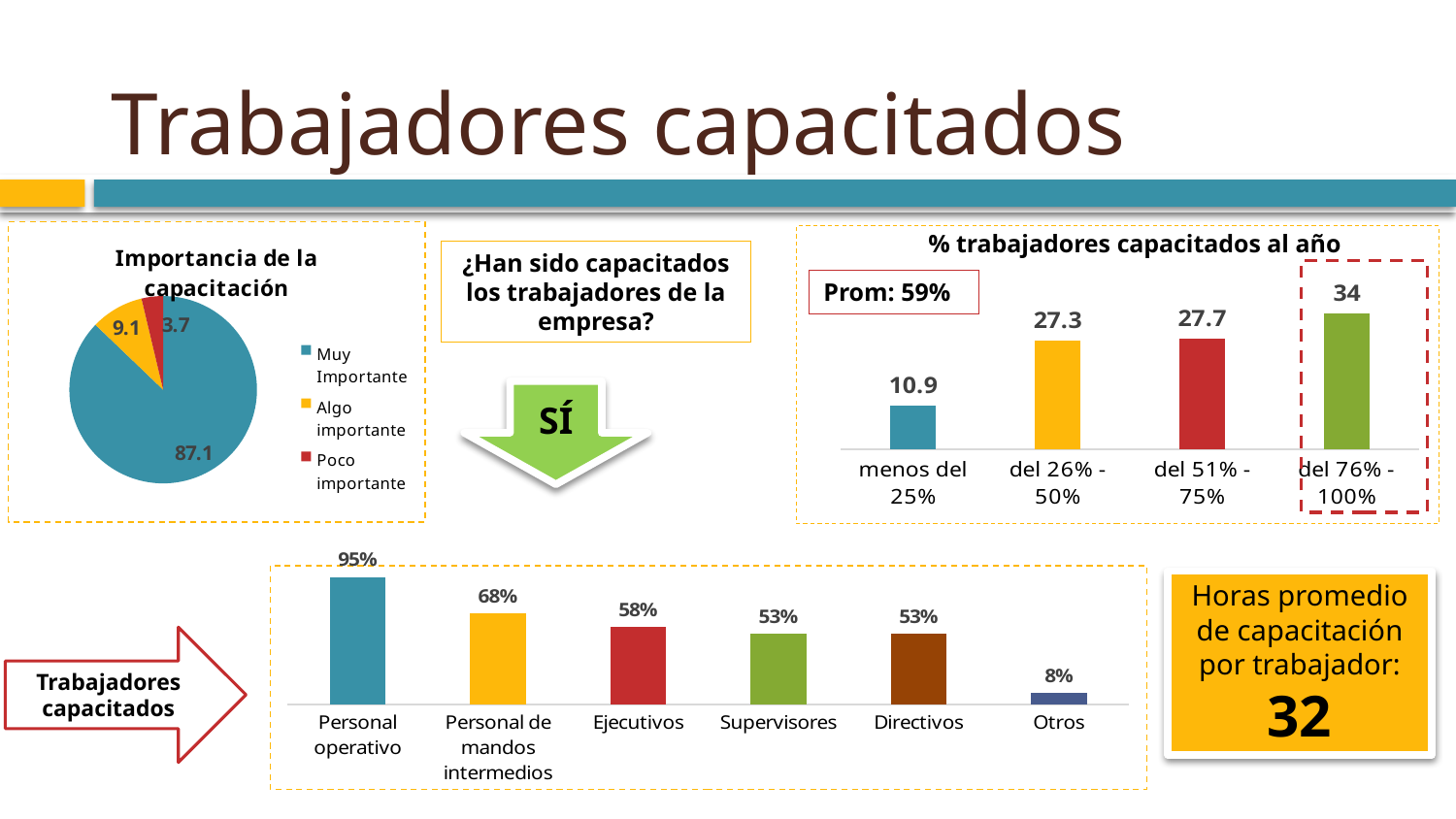
In the chart '% trabajadores capacitados al año', which category has the highest value? del 76% - 100% In the chart '% trabajadores capacitados al año', what is the difference between the values for 'del 76% - 100%' and 'menos del 25%'? 23.1 How many categories does the legend of the pie chart 'Importancia de la capacitación' list? 3 In the pie chart 'Importancia de la capacitación', what is the value for 'Muy Importante'? 87.1 In the chart '% trabajadores capacitados al año', what is the value for 'del 26% - 50%'? 27.3 In the chart '% trabajadores capacitados al año', do the values rise or fall from left to right along the x axis? rise How many categories are shown in the bottom bar chart 'Trabajadores capacitados'? 6 In the bottom bar chart 'Trabajadores capacitados', which is larger, the value for 'Personal operativo' or 'Personal de mandos intermedios'? Personal operativo In the pie chart 'Importancia de la capacitación', which category has the smallest slice? Poco importante In the bottom bar chart 'Trabajadores capacitados', what is the value for 'Ejecutivos'? 58% In the bottom bar chart 'Trabajadores capacitados', which category has the lowest value? Otros What kind of chart is '% trabajadores capacitados al año'? bar chart